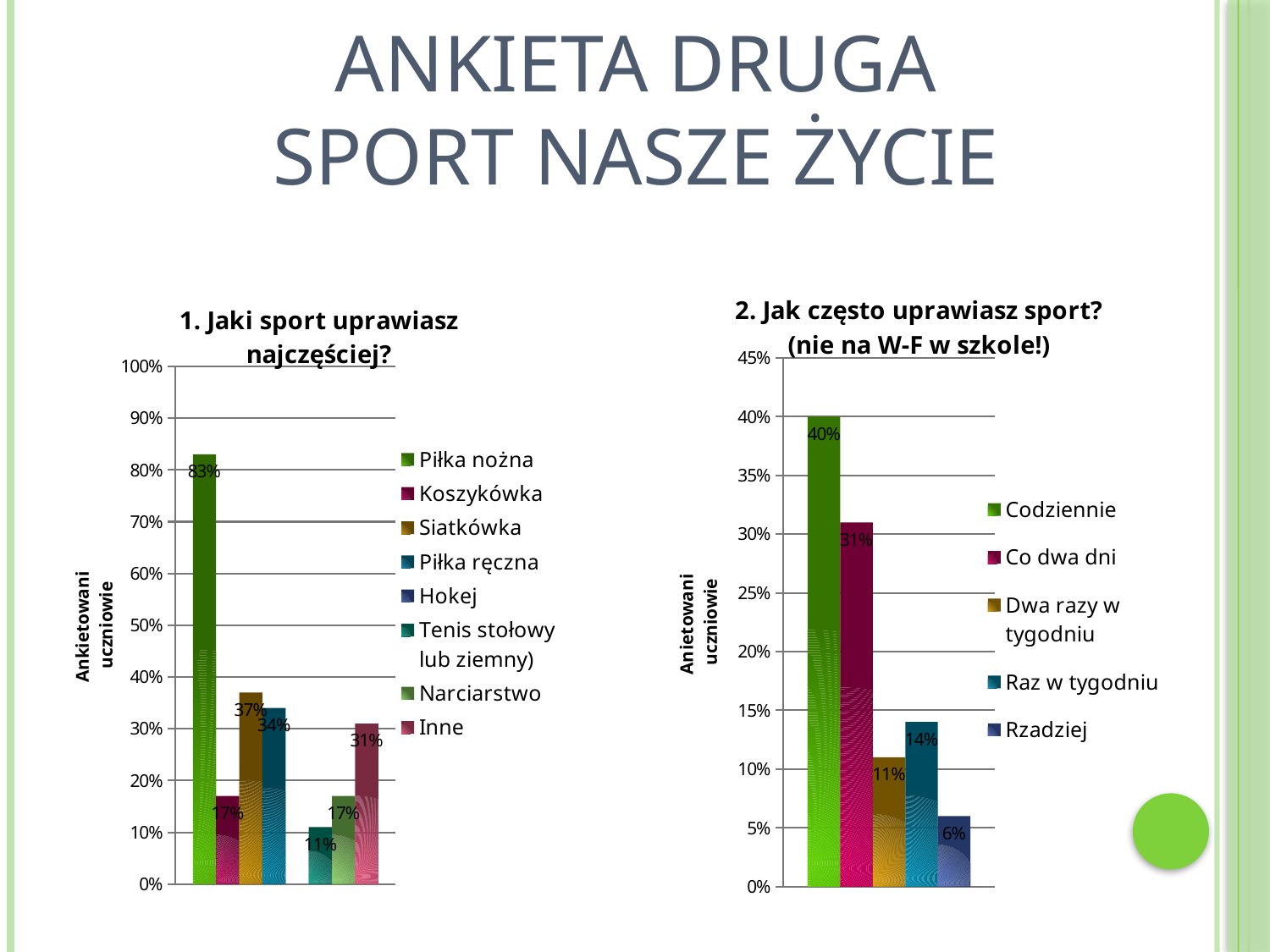
In the chart '2. Jak często uprawiasz sport?', which is larger: Dwa razy w tygodniu or Raz w tygodniu? Raz w tygodniu In the chart '1. Jaki sport uprawiasz najczęściej?', which sport has the highest value? Piłka nożna In the chart '1. Jaki sport uprawiasz najczęściej?', how many entries does the legend list? 8 In the chart '2. Jak często uprawiasz sport?', which category has the lowest value? Rzadziej What kind of chart is '2. Jak często uprawiasz sport?'? Bar chart In the chart '1. Jaki sport uprawiasz najczęściej?', which is larger: Inne or Piłka ręczna? Piłka ręczna In the chart '2. Jak często uprawiasz sport?', what is the value for Rzadziej? 6% In the chart '1. Jaki sport uprawiasz najczęściej?', what is the value for Piłka nożna? 83% In the chart '1. Jaki sport uprawiasz najczęściej?', what is the difference between Siatkówka and Piłka ręczna? 3 percentage points In the chart '1. Jaki sport uprawiasz najczęściej?', what is the value for Siatkówka? 37% In the chart '2. Jak często uprawiasz sport?', what is the difference between Codziennie and Co dwa dni? 9 percentage points In the chart '2. Jak często uprawiasz sport?', what is the value for Codziennie? 40%